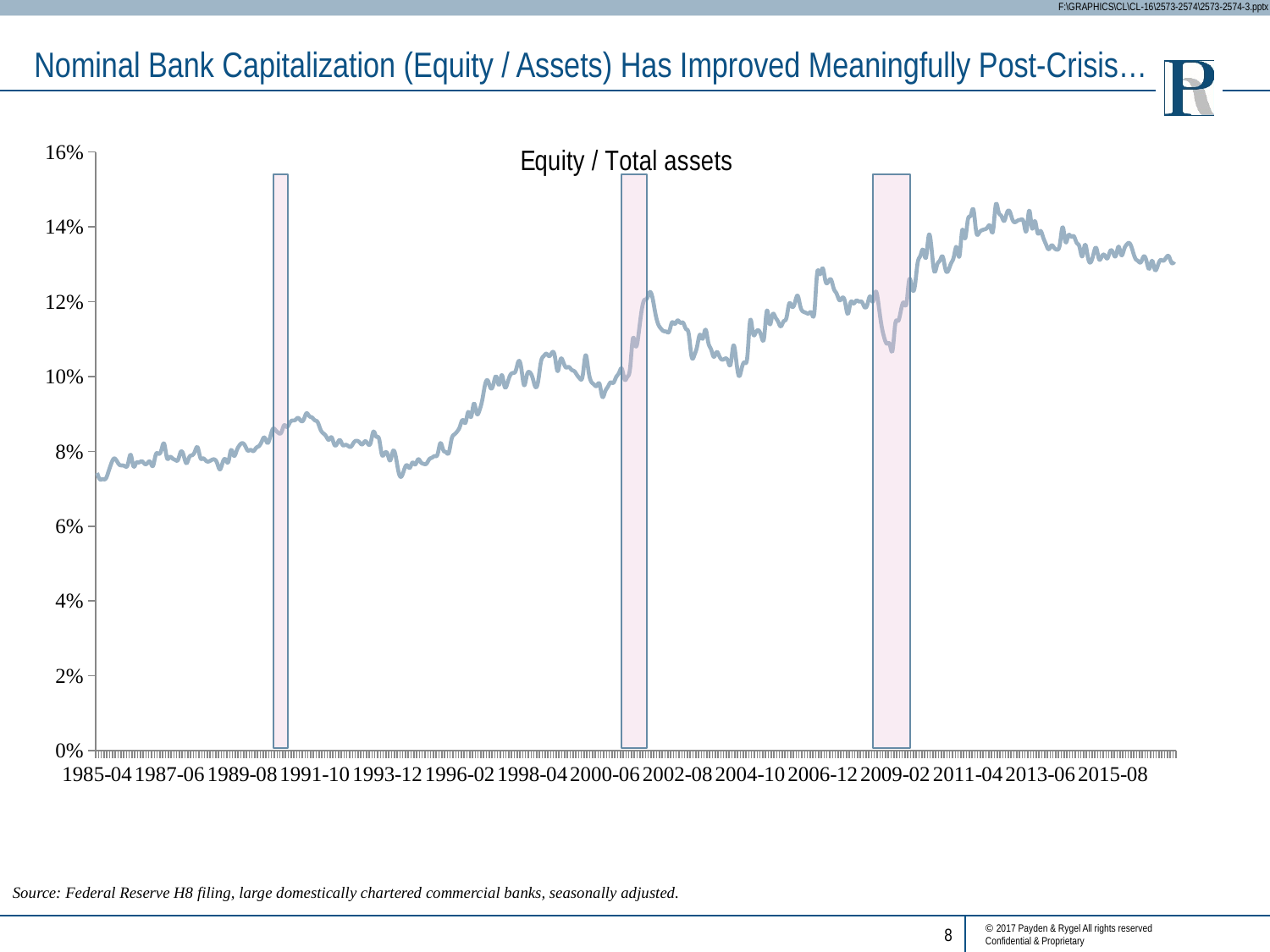
What is the title of the chart? Equity / Total assets Is the value for Equity / Total assets at 1996-02 greater or less than 8%? greater Is the value for Equity / Total assets at 1985-04 greater or less than 8%? less Overall, does the Equity / Total assets line rise or fall from 1985-04 to 2015-08? rise How many date labels are shown on the x axis? 15 Is the value for Equity / Total assets at 2015-08 greater or less than 12%? greater Which is larger, the Equity / Total assets value at 2011-04 or at 1991-10? 2011-04 What kind of chart is shown on the slide? line chart Which is larger, the Equity / Total assets value at 2015-08 or at 1985-04? 2015-08 How many shaded vertical bands are drawn on the chart? 3